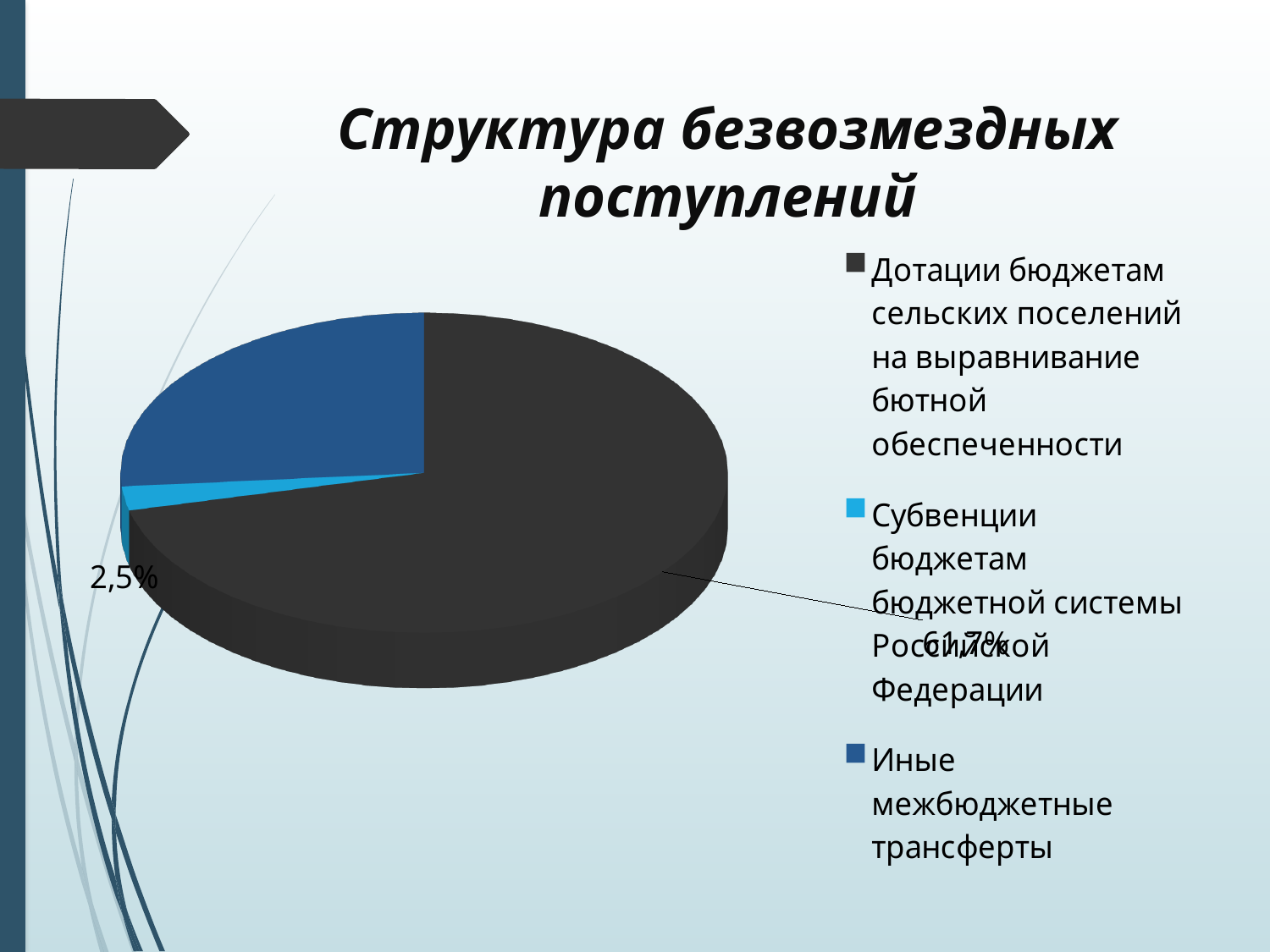
Which category has the largest slice of the pie? Дотации бюджетам сельских поселений на выравнивание бюджетной обеспеченности What share of the pie is labelled for Дотации бюджетам сельских поселений на выравнивание бюджетной обеспеченности? 61,7% By how many percentage points does the Дотации slice (61,7%) exceed the Субвенции slice (2,5%)? 59,2 What share of the pie is labelled for Субвенции бюджетам бюджетной системы Российской Федерации? 2,5% Which slice is larger: Иные межбюджетные трансферты or Субвенции бюджетам бюджетной системы Российской Федерации? Иные межбюджетные трансферты Which slice is larger: Дотации бюджетам сельских поселений or Иные межбюджетные трансферты? Дотации бюджетам сельских поселений What kind of chart is shown on the slide? Pie chart What is the title of the chart? Структура безвозмездных поступлений Which category has the smallest slice of the pie? Субвенции бюджетам бюджетной системы Российской Федерации How many categories does the legend list? 3 What colour is the slice for Дотации бюджетам сельских поселений на выравнивание бюджетной обеспеченности? Dark grey